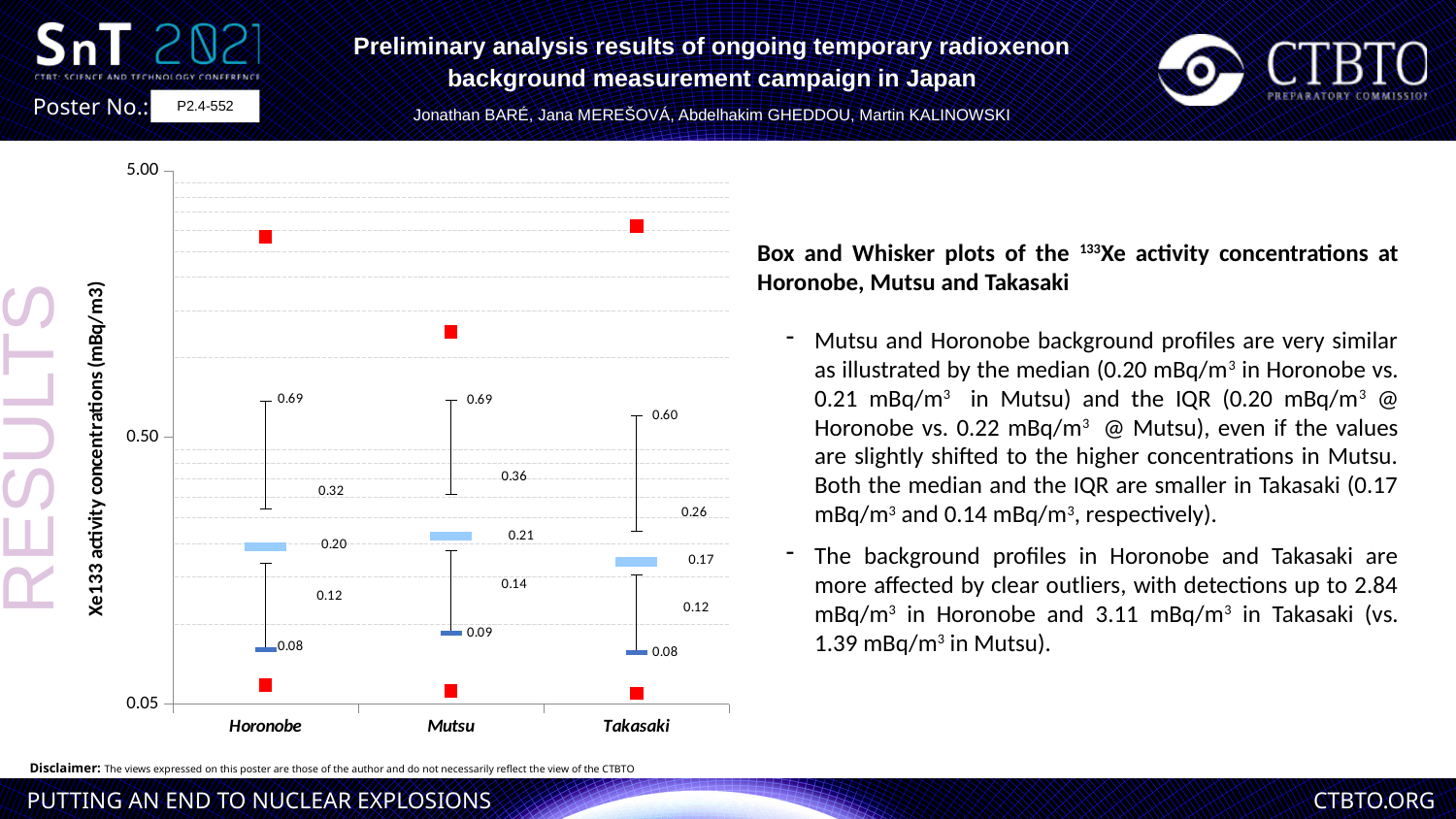
Which station has the highest labelled upper quartile (box top) value in the chart? Mutsu What is the median value labelled for Horonobe in the chart? 0.20 Is the highest red outlier point for Takasaki greater or less than 0.50 on the y axis? greater How many stations (categories) are plotted on the x axis of the chart? 3 What kind of chart is shown on the slide? Box and whisker plot Is the upper whisker value for Horonobe larger or smaller than the upper whisker value for Takasaki? Larger What is the difference between the upper quartile labels of Mutsu (0.36) and Takasaki (0.26)? 0.10 What is the label of the y axis of the chart? Xe133 activity concentrations (mBq/m3) What is the lower whisker value labelled for Mutsu in the chart? 0.09 What is the upper whisker value labelled for Takasaki in the chart? 0.60 What is the median value labelled for Mutsu in the chart? 0.21 Which station has the lowest labelled median in the chart? Takasaki